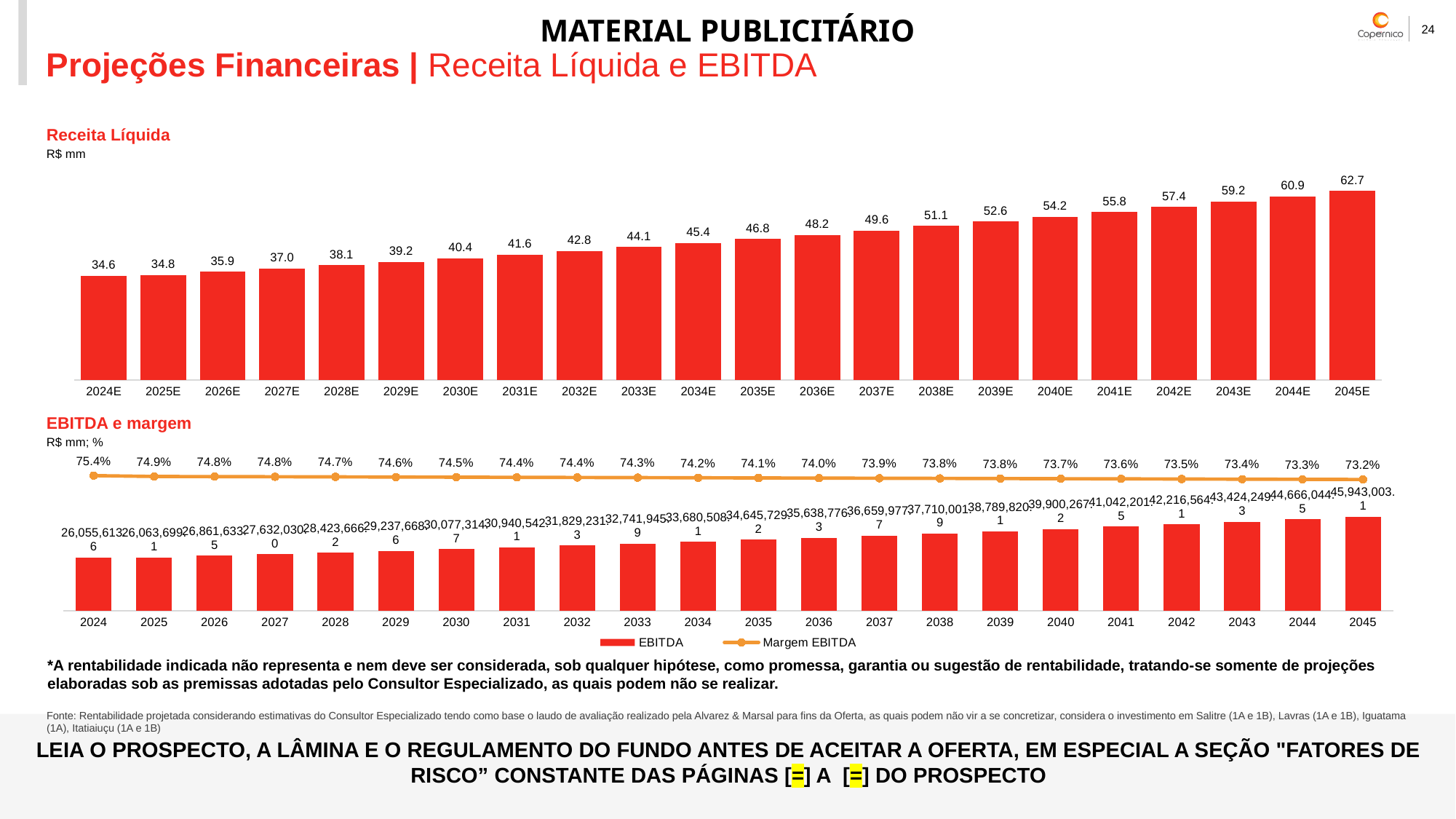
In the EBITDA e margem chart, does the Margem EBITDA line rise or fall from 2024 to 2045? fall What kind of chart is the Receita Líquida chart? bar chart In the Receita Líquida chart, which year has the lowest value? 2024E In the Receita Líquida chart, do the values rise or fall from 2024E to 2045E? rise In the Receita Líquida chart, what is the value for 2045E? 62.7 In the Receita Líquida chart, what is the difference between the values for 2045E and 2024E? 28.1 In the EBITDA e margem chart, what is the Margem EBITDA for 2024? 75.4% In the Receita Líquida chart, what is the value for 2030E? 40.4 In the Receita Líquida chart, which year has the highest value? 2045E In the EBITDA e margem chart, how many series does the legend list? 2 In the Receita Líquida chart, how many years are shown on the x axis? 22 In the EBITDA e margem chart, what is the Margem EBITDA for 2045? 73.2%